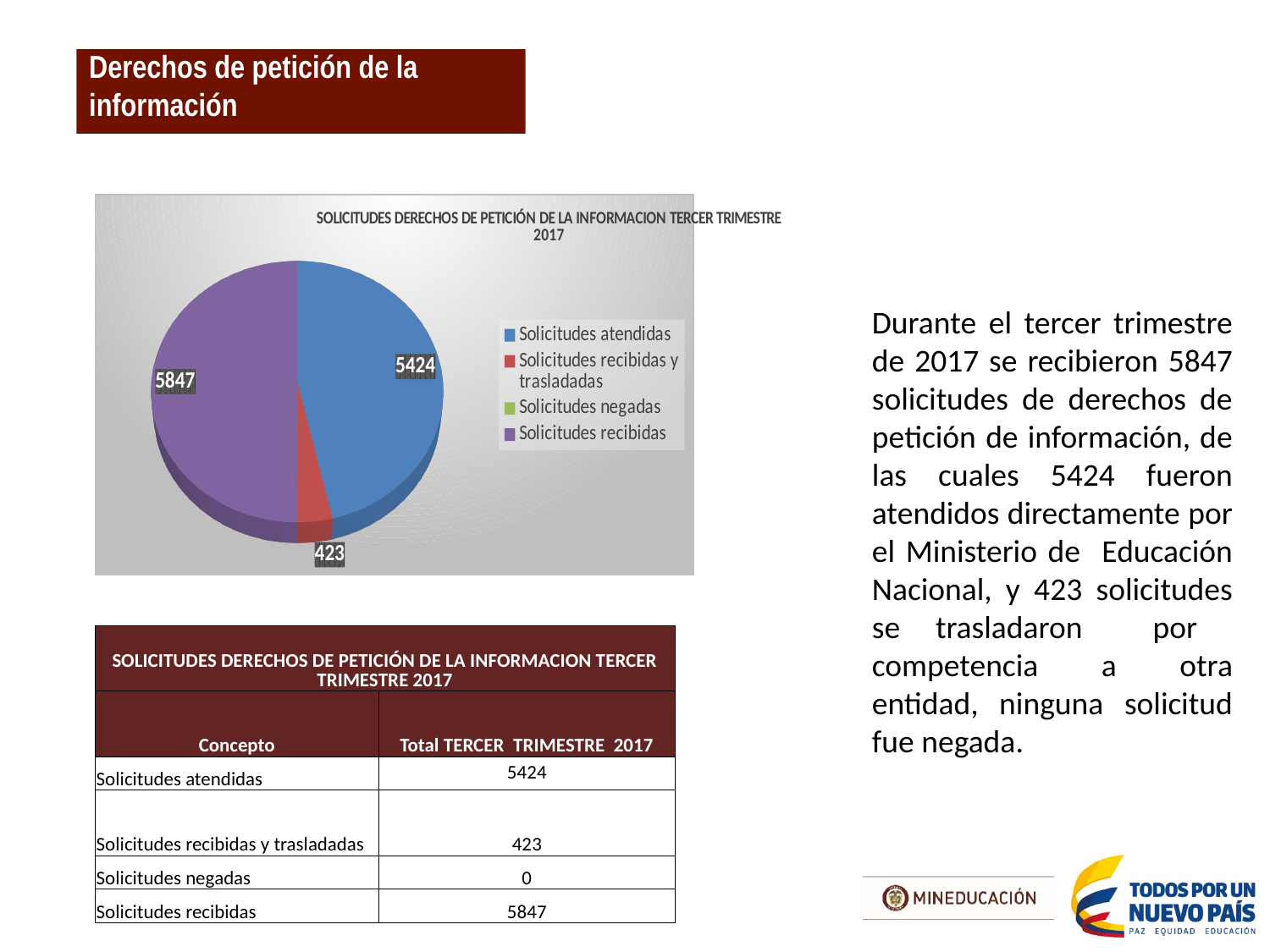
What value is shown for Solicitudes atendidas in the pie chart? 5424 What value is shown for Solicitudes recibidas y trasladadas in the pie chart? 423 How many entries does the legend of the pie chart list? 4 What is the title of the chart? SOLICITUDES DERECHOS DE PETICIÓN DE LA INFORMACION TERCER TRIMESTRE 2017 What is the difference between the values for Solicitudes atendidas and Solicitudes recibidas y trasladadas in the pie chart? 5001 Which is larger in the pie chart: Solicitudes atendidas or Solicitudes recibidas y trasladadas? Solicitudes atendidas Which category has the largest slice in the pie chart? Solicitudes recibidas What is the difference between the values for Solicitudes recibidas and Solicitudes atendidas in the pie chart? 423 Which category with a printed value has the smallest slice in the pie chart? Solicitudes recibidas y trasladadas What kind of chart is shown on the slide? Pie chart What value is shown for Solicitudes recibidas in the pie chart? 5847 What colour represents Solicitudes atendidas in the pie chart? Blue